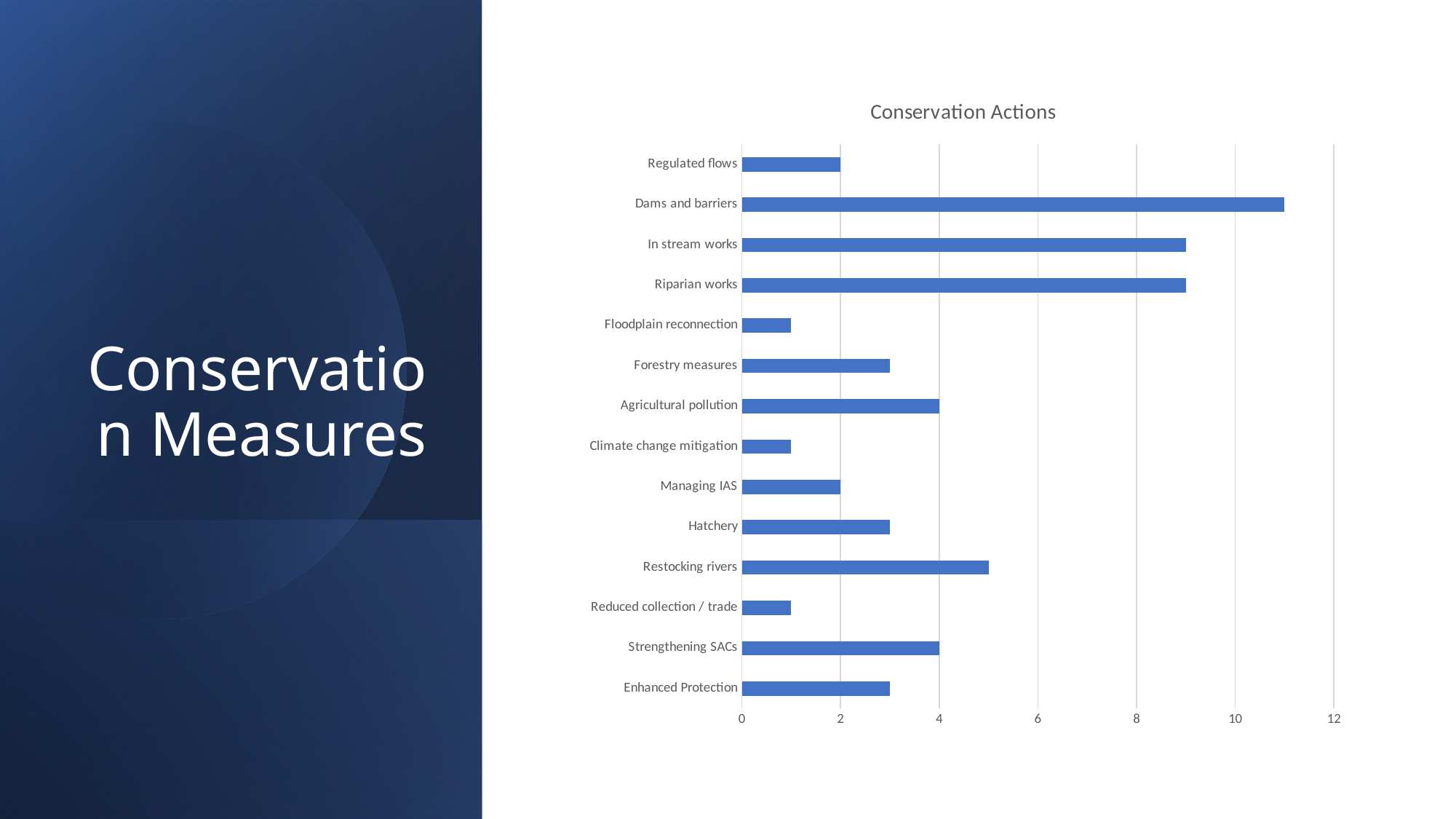
What is the value for Managing IAS? 2 How many conservation actions are shown in the chart? 14 What is the value for Regulated flows? 2 Is the value for Dams and barriers greater or less than 10? greater Which conservation action has the highest value? Dams and barriers What is the value for Agricultural pollution? 4 Is the value for Restocking rivers greater or less than 4? greater Which is larger, the value for Dams and barriers or the value for In stream works? Dams and barriers What kind of chart is shown on the slide? Bar chart Is the value for Floodplain reconnection greater or less than 2? less What is the difference between the values for Agricultural pollution and Regulated flows? 2 What is the value for Strengthening SACs? 4